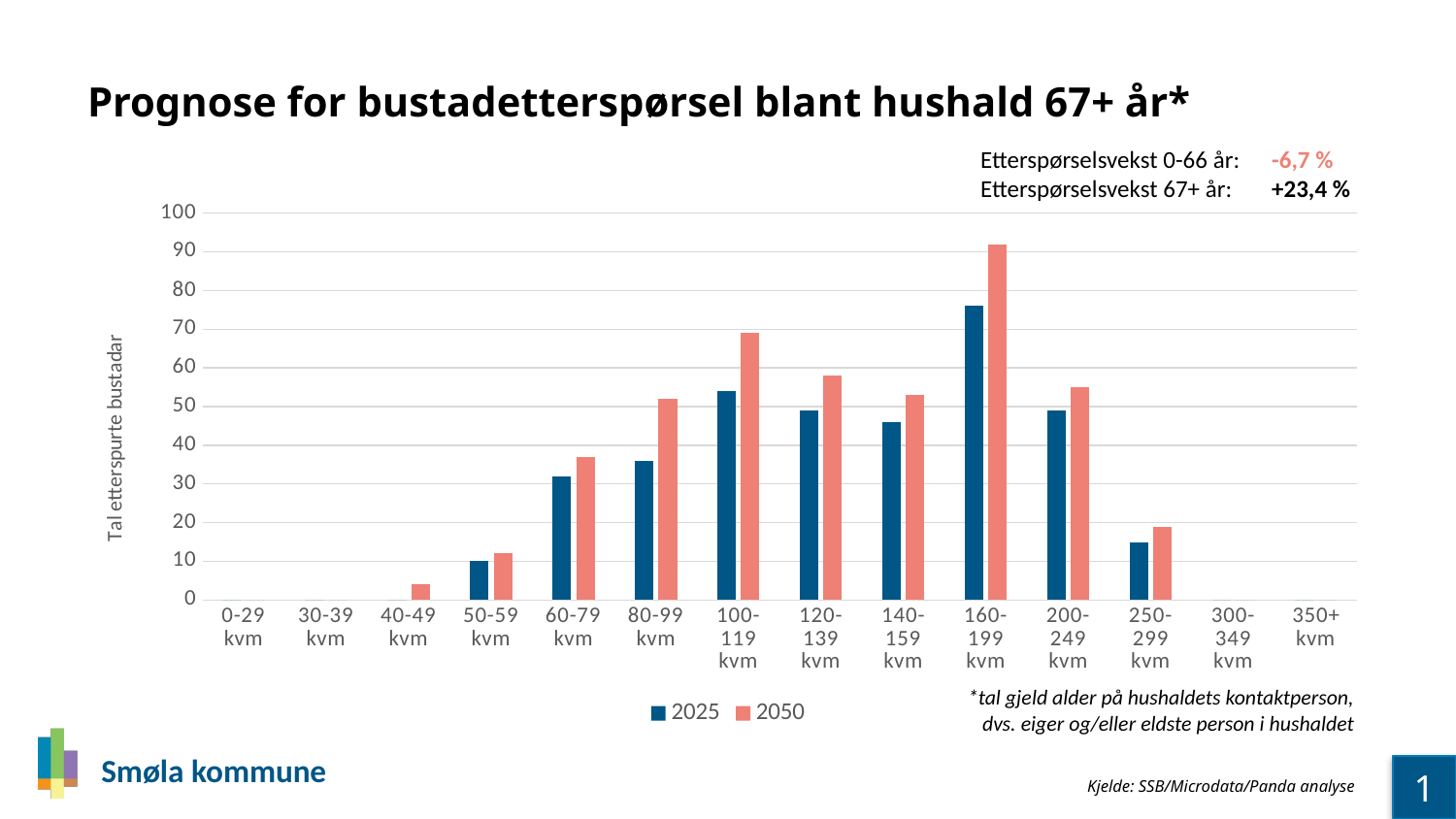
For 100-119 kvm, which series has the larger value, 2025 or 2050? 2050 What kind of chart is shown on the slide? bar chart Is the 2050 value for 160-199 kvm greater or less than 80? greater What is the label of the y axis? Tal etterspurte bustadar Is the 2025 value for 160-199 kvm greater or less than 70? greater Is the 2050 value for 40-49 kvm greater or less than 10? less Which size category has the highest value for the 2025 series? 160-199 kvm Which two series are listed in the legend? 2025 and 2050 Which size category has the highest value for the 2050 series? 160-199 kvm How many size categories are shown on the x axis? 14 How many series does the legend list? 2